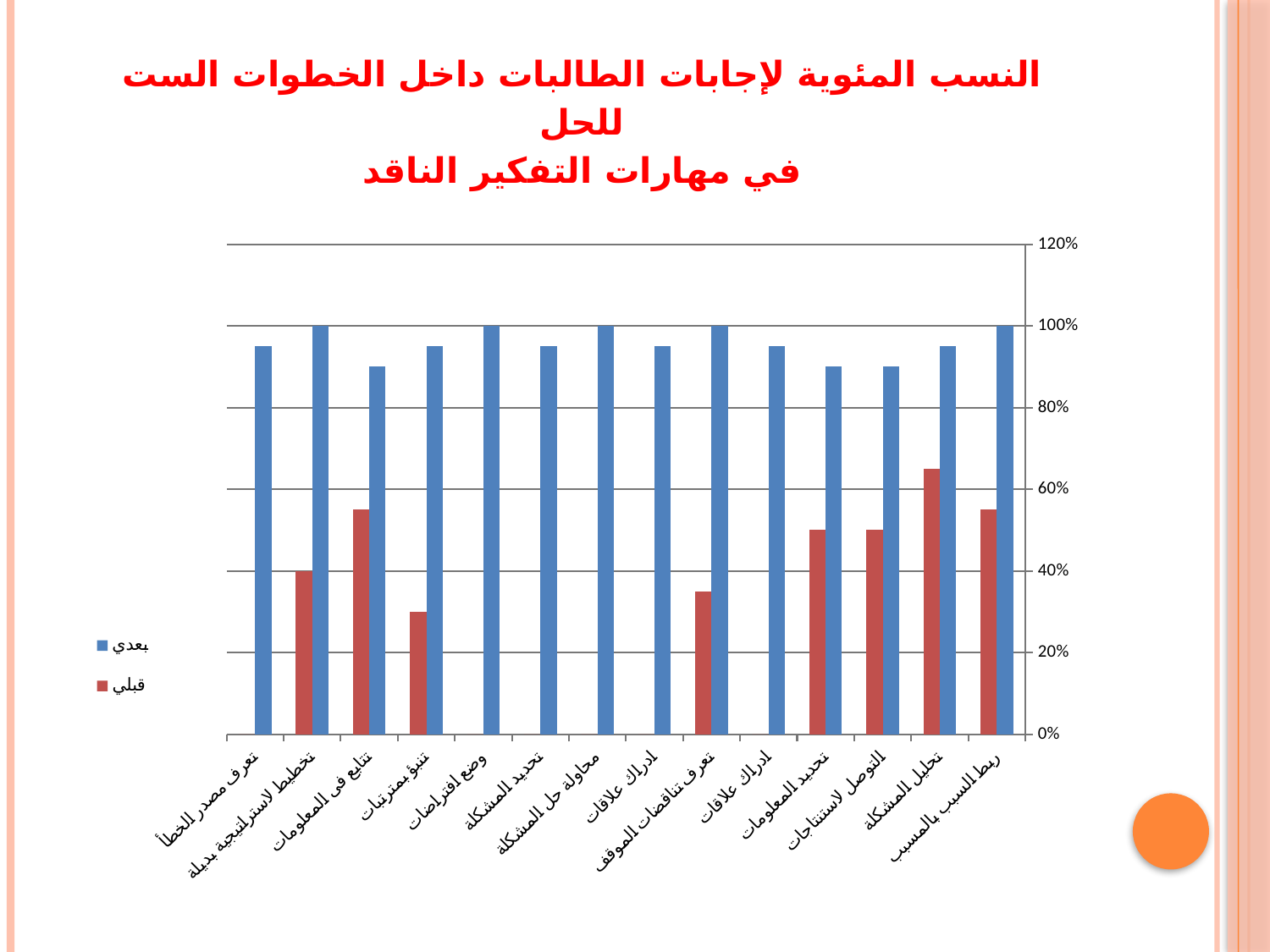
Is the قبلي value for تتابع في المعلومات greater or less than 40%? greater What kind of chart is shown on the slide? bar chart What is the قبلي value for تخطيط لاستراتيجية بديلة? 40% Which colour represents the بعدي series? blue How many categories are shown on the x axis? 14 What are the two series named in the legend? بعدي and قبلي What is the بعدي value for ربط السبب بالمسبب? 100% What is the بعدي value for وضع افتراضات? 100% Which is larger: the قبلي value for تحليل المشكلة or the قبلي value for تخطيط لاستراتيجية بديلة? تحليل المشكلة Is the قبلي value for تنبؤ بمترتبات greater or less than 40%? less How many series does the legend list? 2 Which category has the highest قبلي value? تحليل المشكلة